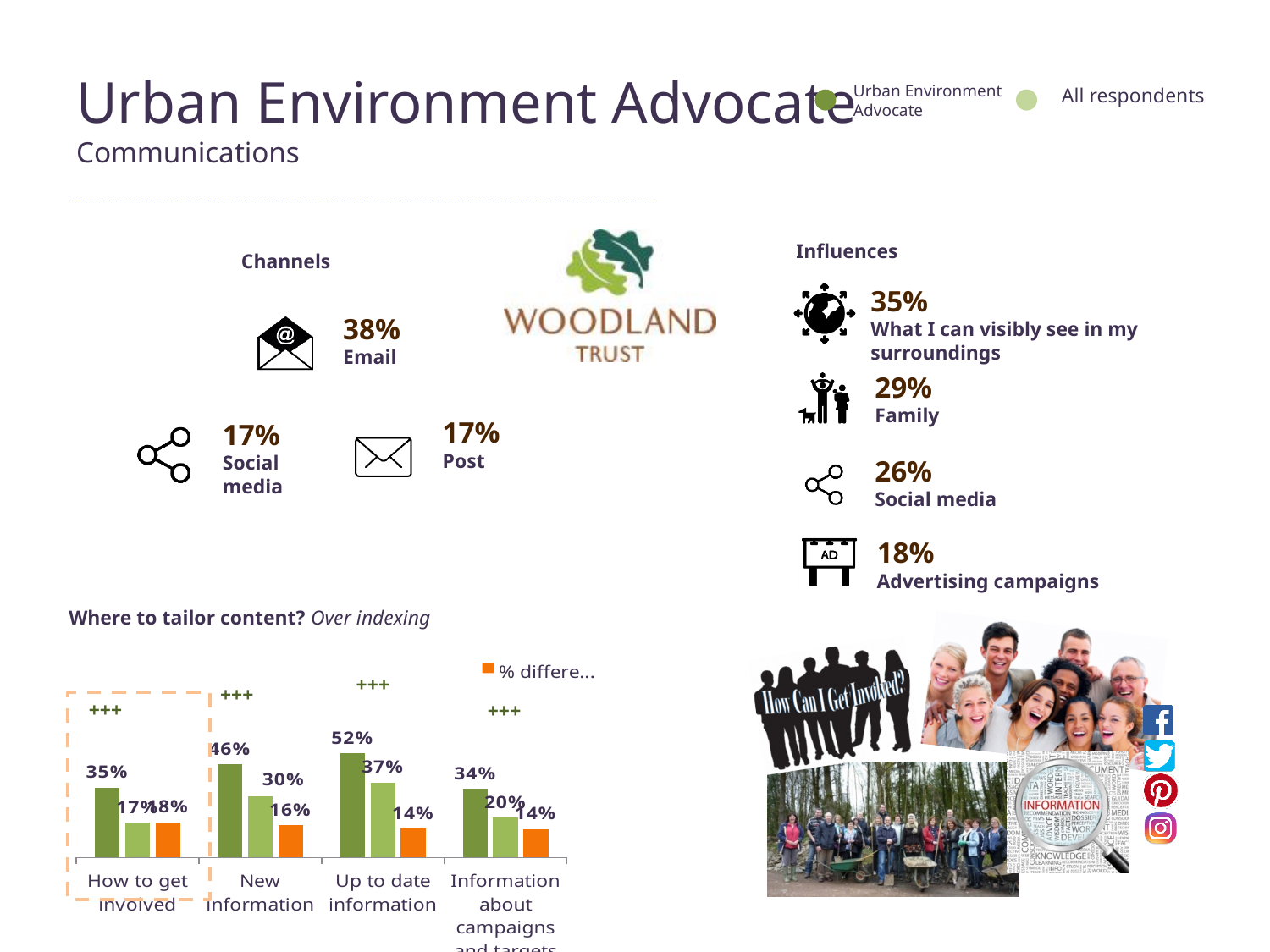
In the 'Where to tailor content?' chart, what is the % difference value for 'How to get involved'? 18% In the 'Where to tailor content?' chart, what is the All respondents value for 'New information'? 30% In the 'Where to tailor content?' chart, which category has the lowest All respondents value? How to get involved In the 'Where to tailor content?' chart, which category is highlighted with a dashed orange box? How to get involved In the 'Where to tailor content?' chart, which is larger for 'Up to date information': the Urban Environment Advocate value or the All respondents value? Urban Environment Advocate In the 'Where to tailor content?' chart, what is the difference between the Urban Environment Advocate and All respondents values for 'New information'? 16% How many categories are shown on the x axis of the 'Where to tailor content?' chart? 4 In the 'Where to tailor content?' chart, what is the Urban Environment Advocate value for 'Information about campaigns and targets'? 34% In the 'Where to tailor content?' chart, what is the Urban Environment Advocate value for 'Up to date information'? 52% What kind of chart is the 'Where to tailor content?' chart? bar chart In the 'Where to tailor content?' chart, which category has the highest Urban Environment Advocate value? Up to date information In the 'Where to tailor content?' chart, what is the difference between the Urban Environment Advocate values for 'Up to date information' and 'How to get involved'? 17%